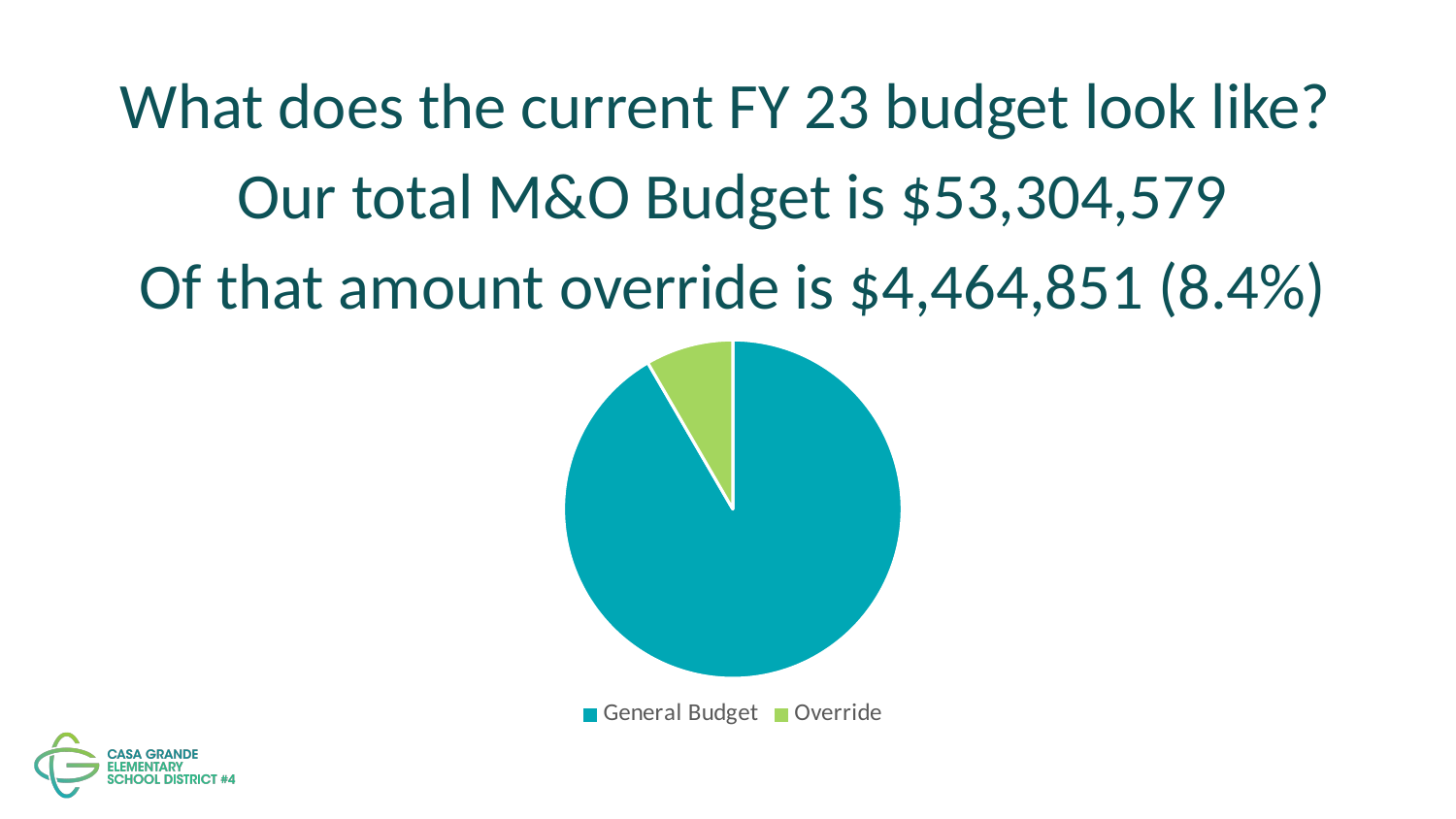
What is the total M&O budget stated on the slide? $53,304,579 Using the total M&O budget and the override amount printed on the slide, what is the General Budget portion in dollars? $48,839,728 Which slice of the pie chart is the largest? General Budget How many entries does the legend of the pie chart list? 2 What colour is the Override slice in the pie chart? Green What are the two legend entries of the pie chart? General Budget and Override Which slice of the pie chart is the smallest? Override What share of the total M&O budget does the Override slice represent, according to the slide? 8.4% How many slices does the pie chart have? 2 What kind of chart is shown on the slide? Pie chart Which is larger in the pie chart, General Budget or Override? General Budget What is the dollar amount of the override shown on the slide? $4,464,851